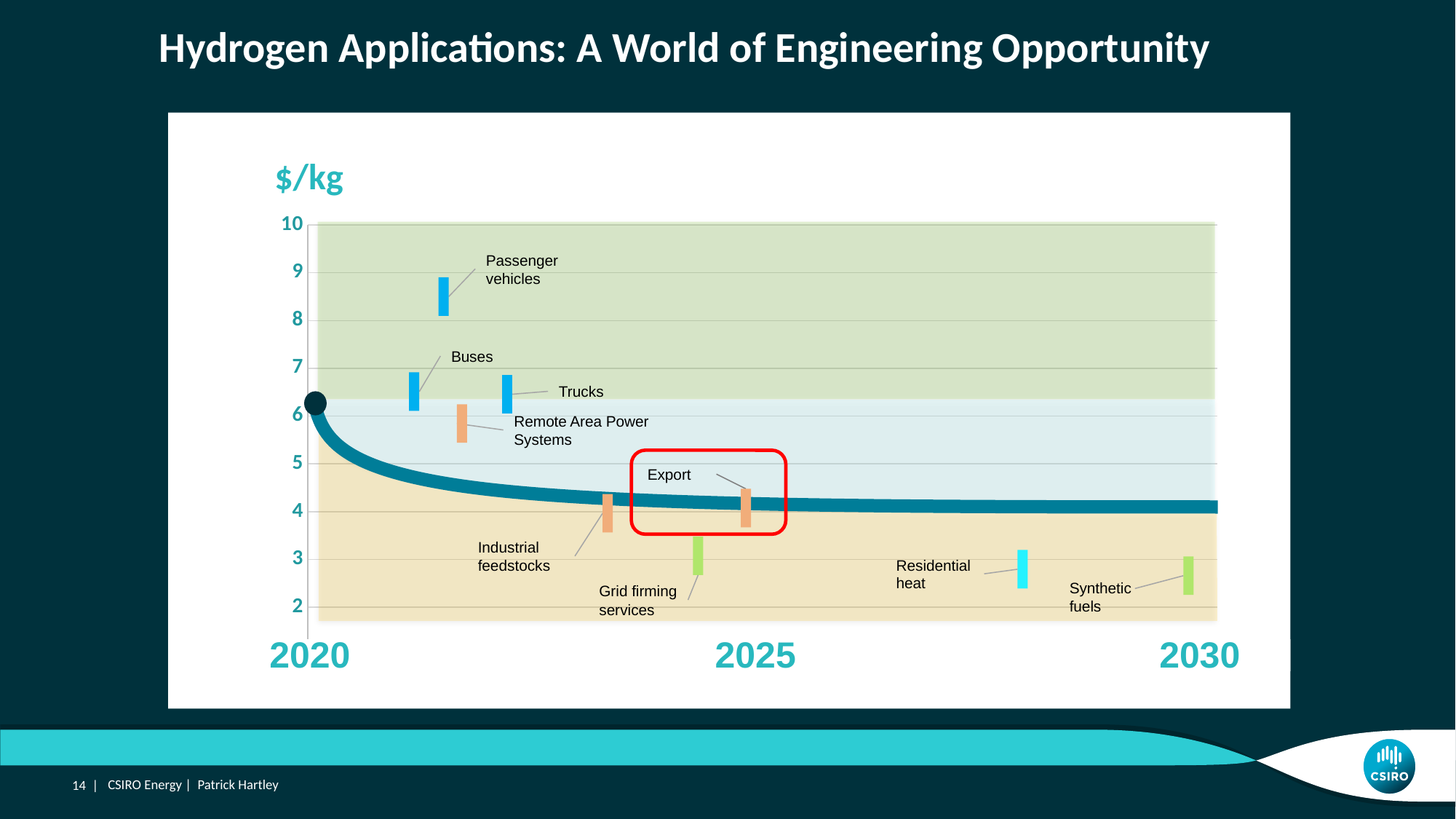
Which is placed higher on the chart, Trucks or Grid firming services? Trucks Is the value for Passenger vehicles greater or less than 8 $/kg? greater How many hydrogen applications are labelled on the chart? 9 What unit is shown on the y axis of the chart? $/kg Is the value for Residential heat greater or less than 4 $/kg? less Is the value for Buses greater or less than 6 $/kg? greater What kind of chart is shown on the slide? line chart Does the cost curve rise or fall from 2020 to 2030? fall Which application is placed at the highest $/kg level on the chart? Passenger vehicles Which application is highlighted with a red box on the chart? Export